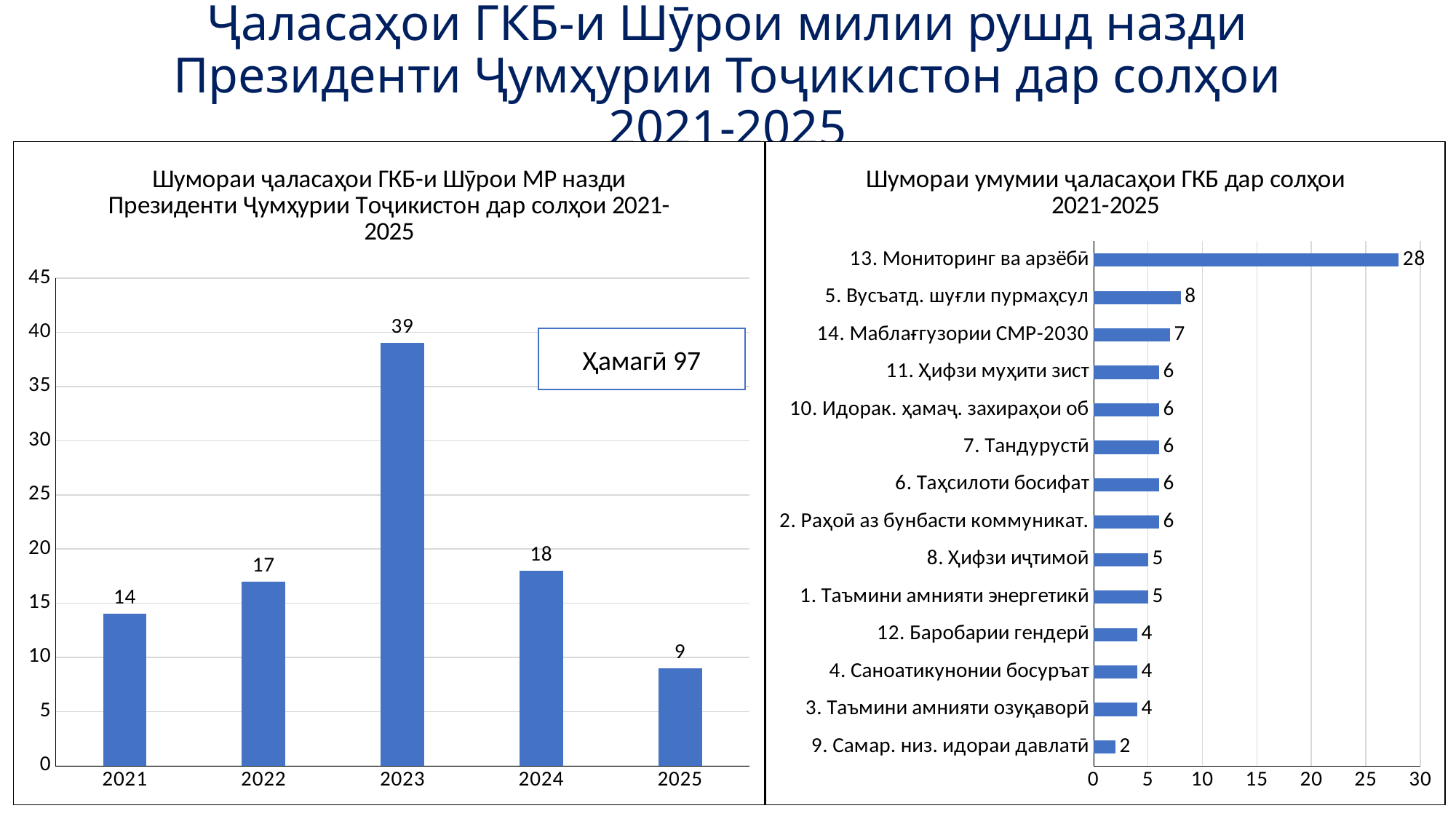
In the right chart, which category has the lowest value? 9. Самар. низ. идораи давлатӣ In the right chart, what is the value for "13. Мониторинг ва арзёбӣ"? 28 In the left chart, how many meetings were held in 2023? 39 What type of chart is the right chart? Bar chart In the left chart, which year has the highest value? 2023 In the left chart, which year has the lowest value? 2025 What total is shown in the text box on the left chart? Ҳамагӣ 97 In the left chart, what is the difference between the values for 2023 and 2024? 21 In the left chart, which is larger, the value for 2022 or the value for 2024? 2024 In the left chart, what is the value for 2025? 9 In the right chart, how many categories are listed? 14 In the left chart, how many years are shown on the x axis? 5